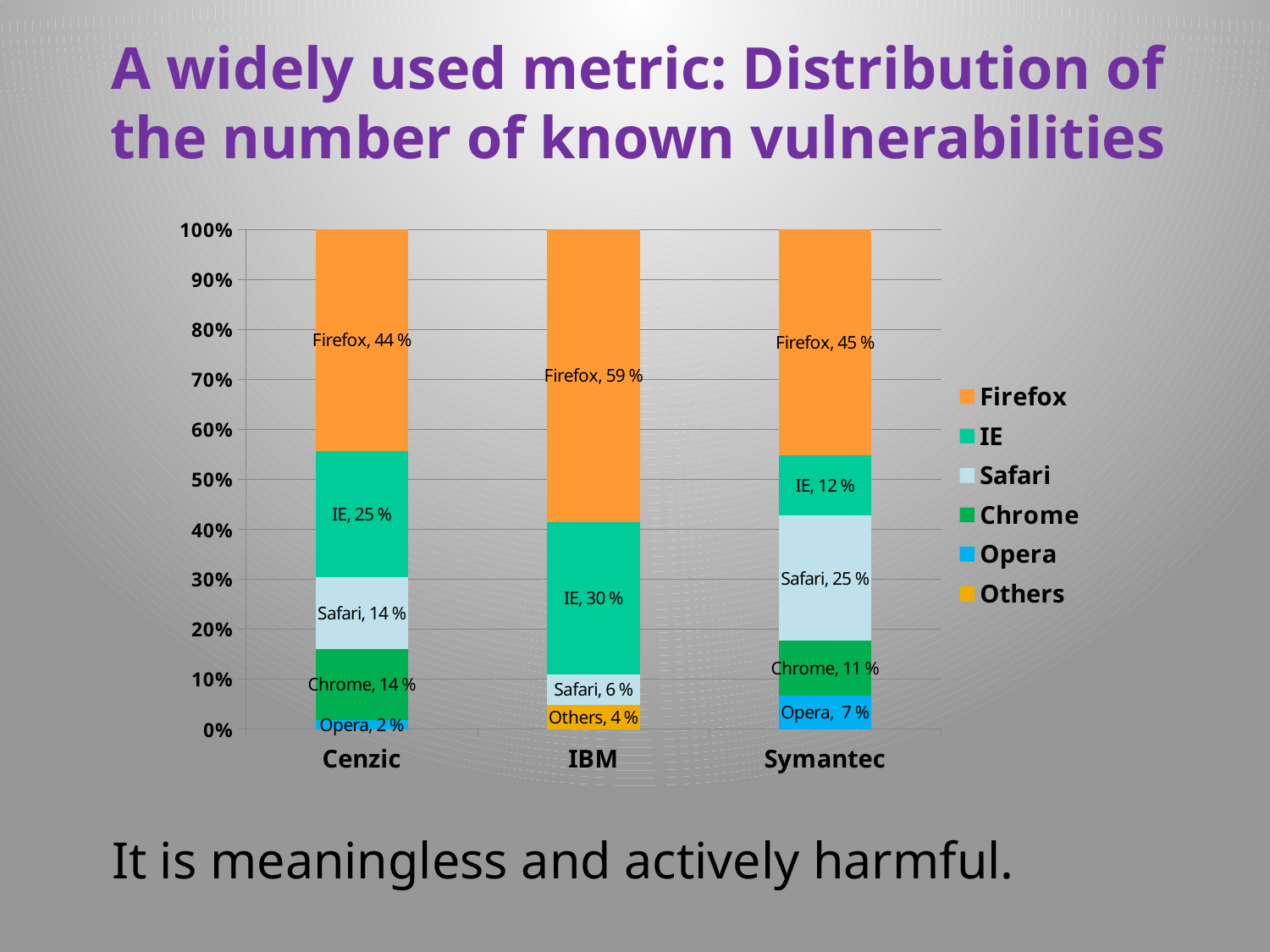
What is the Others share for IBM? 4 % What is the difference between the Firefox share for IBM and the Firefox share for Cenzic? 15 % What is the IE share for Cenzic? 25 % Which source reports the highest Firefox share? IBM Which is larger for Symantec, the Safari share or the IE share? Safari How many series does the legend list? 6 How many sources (categories) are shown on the x axis? 3 What kind of chart is shown on the slide? Stacked bar chart What is the Firefox share for IBM? 59 % What is the Opera share for Symantec? 7 % What is the Safari share for Symantec? 25 % Which source reports the lowest IE share? Symantec